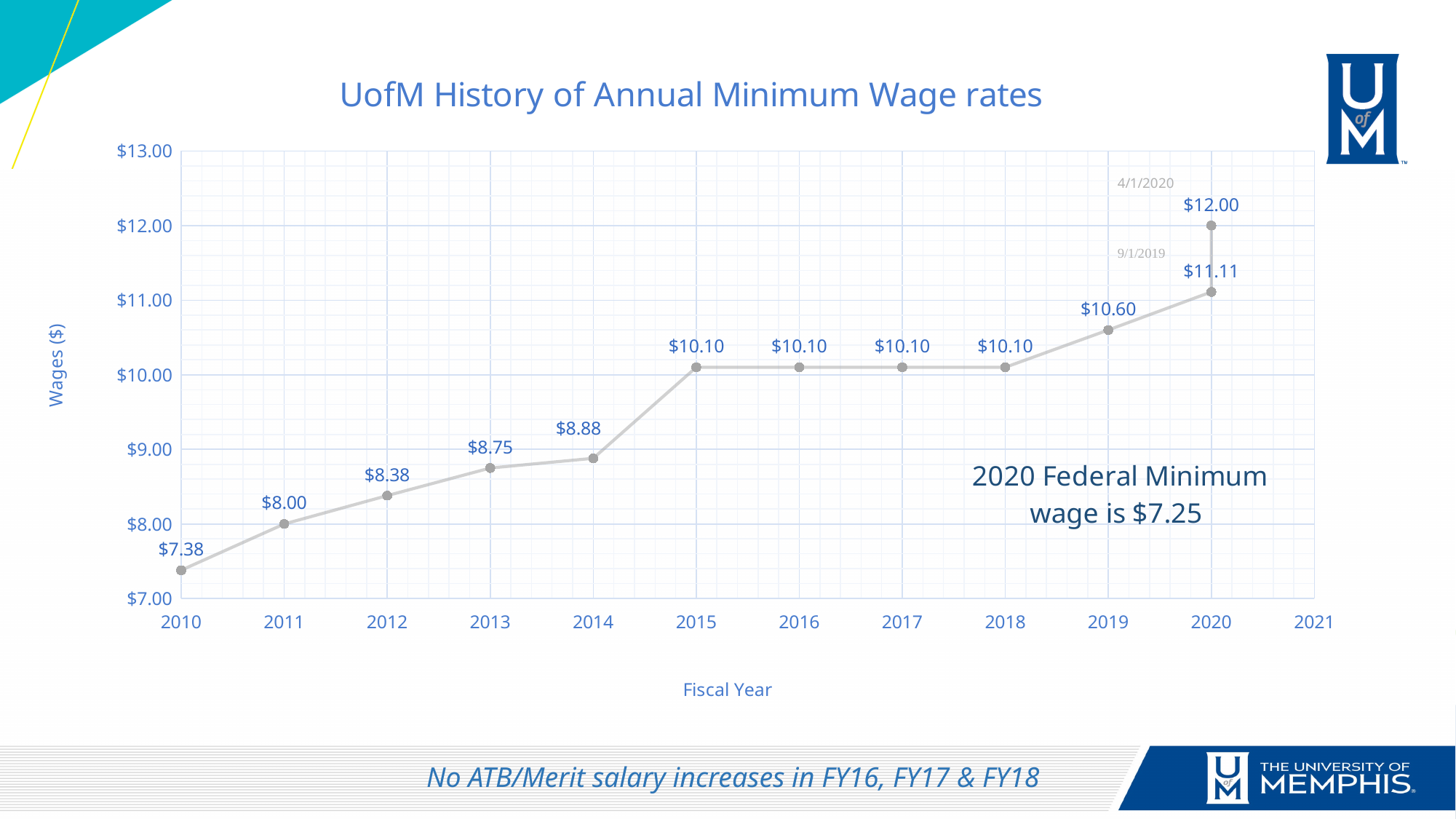
What is the highest wage value labeled on the chart? $12.00 Which is larger, the wage rate for 2012 or the wage rate for 2011? 2012 What is the difference between the two wage values labeled at 2020 ($12.00 and $11.11)? $0.89 Which fiscal year has the lowest minimum wage rate on the chart? 2010 What kind of chart is shown on the slide? Line chart What is the minimum wage rate shown for fiscal year 2010? $7.38 How many data points on the chart are labeled $10.10? 4 What is the minimum wage rate shown for fiscal year 2013? $8.75 What is the difference between the wage rate for 2019 and the wage rate for 2014? $1.72 What is the title of the chart? UofM History of Annual Minimum Wage rates Do the wage rates generally rise or fall from 2010 to 2020? Rise What is the minimum wage rate shown for fiscal year 2019? $10.60